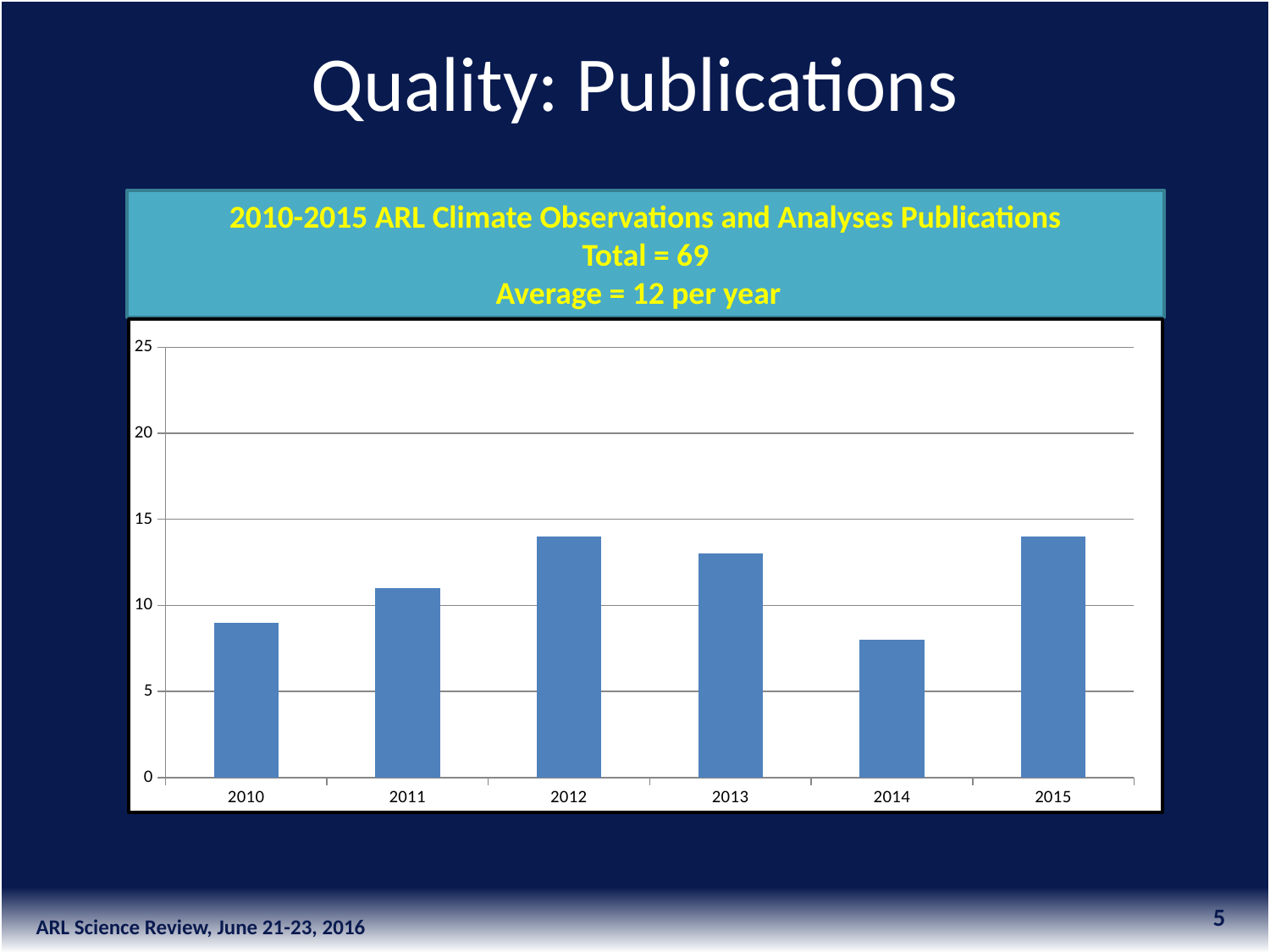
Is the value for 2010 greater or less than 10? less What kind of chart is shown on the slide? bar chart Is the value for 2014 greater or less than 10? less Is the value for 2012 greater or less than 15? less Which year has the lowest bar in the chart? 2014 Which is larger, the value for 2011 or the value for 2010? 2011 What is the title of the chart? 2010-2015 ARL Climate Observations and Analyses Publications How many years are plotted on the x axis of the chart? 6 According to the chart heading, what is the total number of publications for 2010-2015? 69 Do the values rise or fall from 2010 to 2012? rise